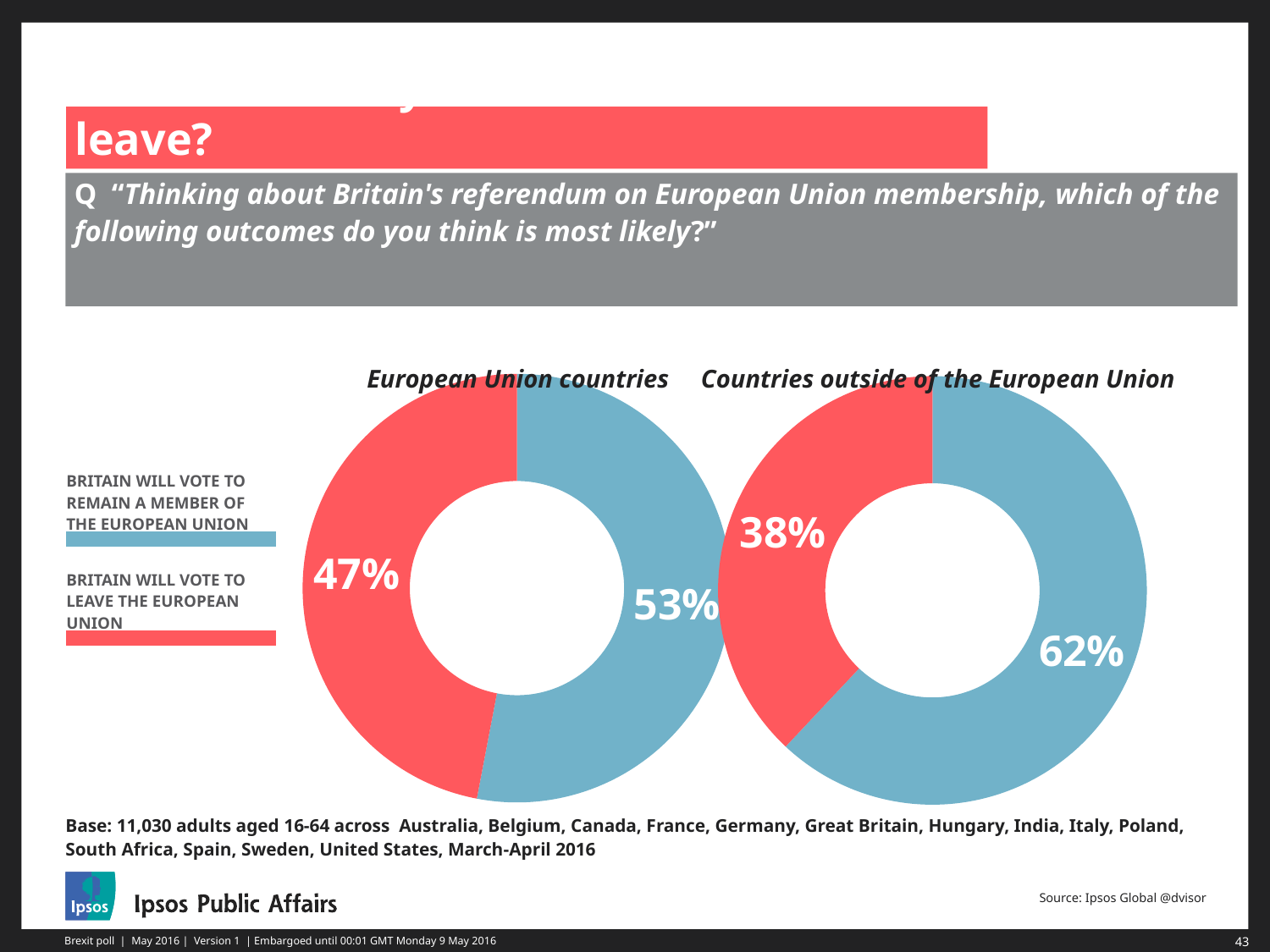
In the 'Countries outside of the European Union' chart, what share think Britain will vote to leave the European Union? 38% What type of chart is used on this slide? Pie chart (donut) In the 'European Union countries' chart, what share think Britain will vote to leave the European Union? 47% In the 'Countries outside of the European Union' chart, what share think Britain will vote to remain a member of the European Union? 62% In the 'Countries outside of the European Union' chart, which outcome has the larger share? Britain will vote to remain a member of the European Union Which colour represents 'Britain will vote to leave the European Union' in the charts? Red How many charts are shown on the slide? 2 In the 'European Union countries' chart, which outcome has the smaller share? Britain will vote to leave the European Union In the 'European Union countries' chart, what is the difference between the remain share and the leave share? 6% In the 'Countries outside of the European Union' chart, what is the difference between the remain share and the leave share? 24% Is the share expecting Britain to vote to leave larger in the 'European Union countries' chart or the 'Countries outside of the European Union' chart? European Union countries In the 'European Union countries' chart, what share think Britain will vote to remain a member of the European Union? 53%